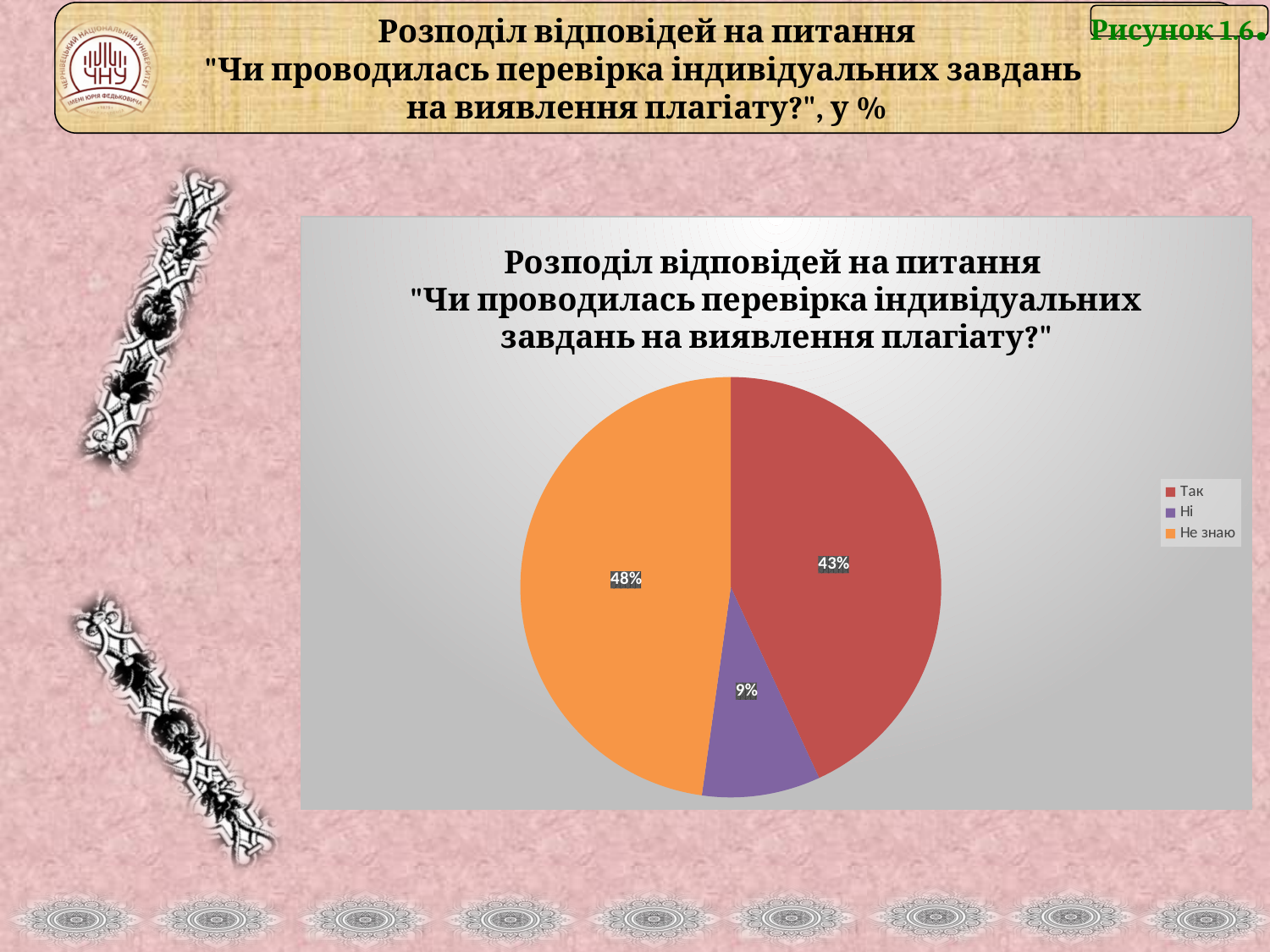
What is the difference in percentage points between "Не знаю" and "Так"? 5 What percentage of respondents answered "Так"? 43% What percentage of respondents answered "Ні"? 9% What kind of chart is shown on the slide? pie chart How many entries does the legend list? 3 What is the difference in percentage points between "Так" and "Ні"? 34 What percentage of respondents answered "Не знаю"? 48% Which is larger, the share for "Так" or the share for "Ні"? Так How many slices does the pie chart have? 3 What colour is the slice for "Не знаю"? orange Which answer has the smallest share of the pie? Ні Which answer has the largest share of the pie? Не знаю